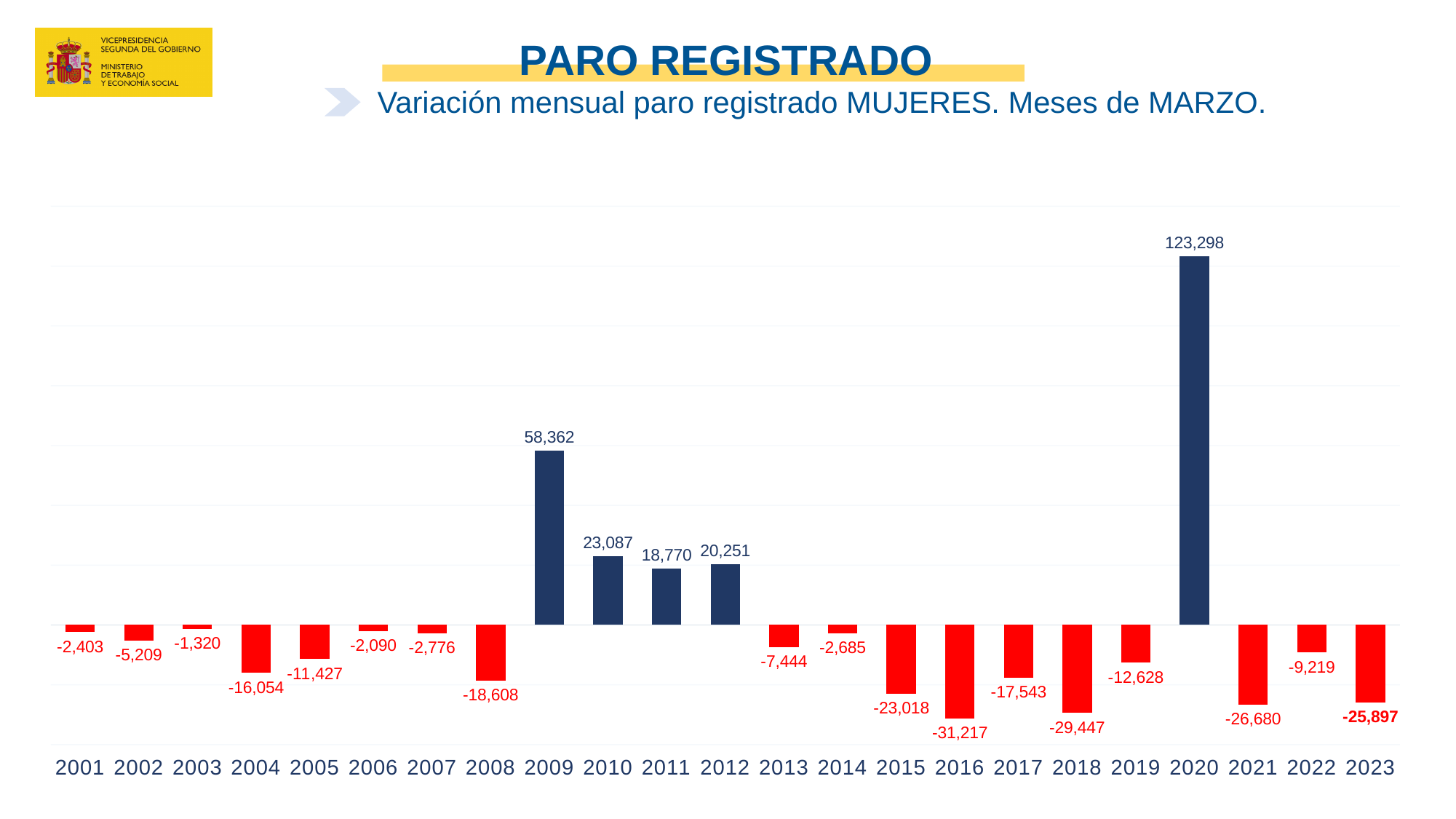
Which year has the lowest value? 2016 What colour are the bars with negative values? Red What is the value shown for 2020? 123,298 Which year has the larger value, 2010 or 2012? 2010 How many years are shown on the x axis? 23 What is the value shown for 2009? 58,362 What kind of chart is shown on the slide? Bar chart What is the value shown for 2016? -31,217 What is the difference between the values for 2020 and 2009? 64,936 What is the value shown for 2023? -25,897 How many years show a positive value? 5 Which year has the highest value? 2020